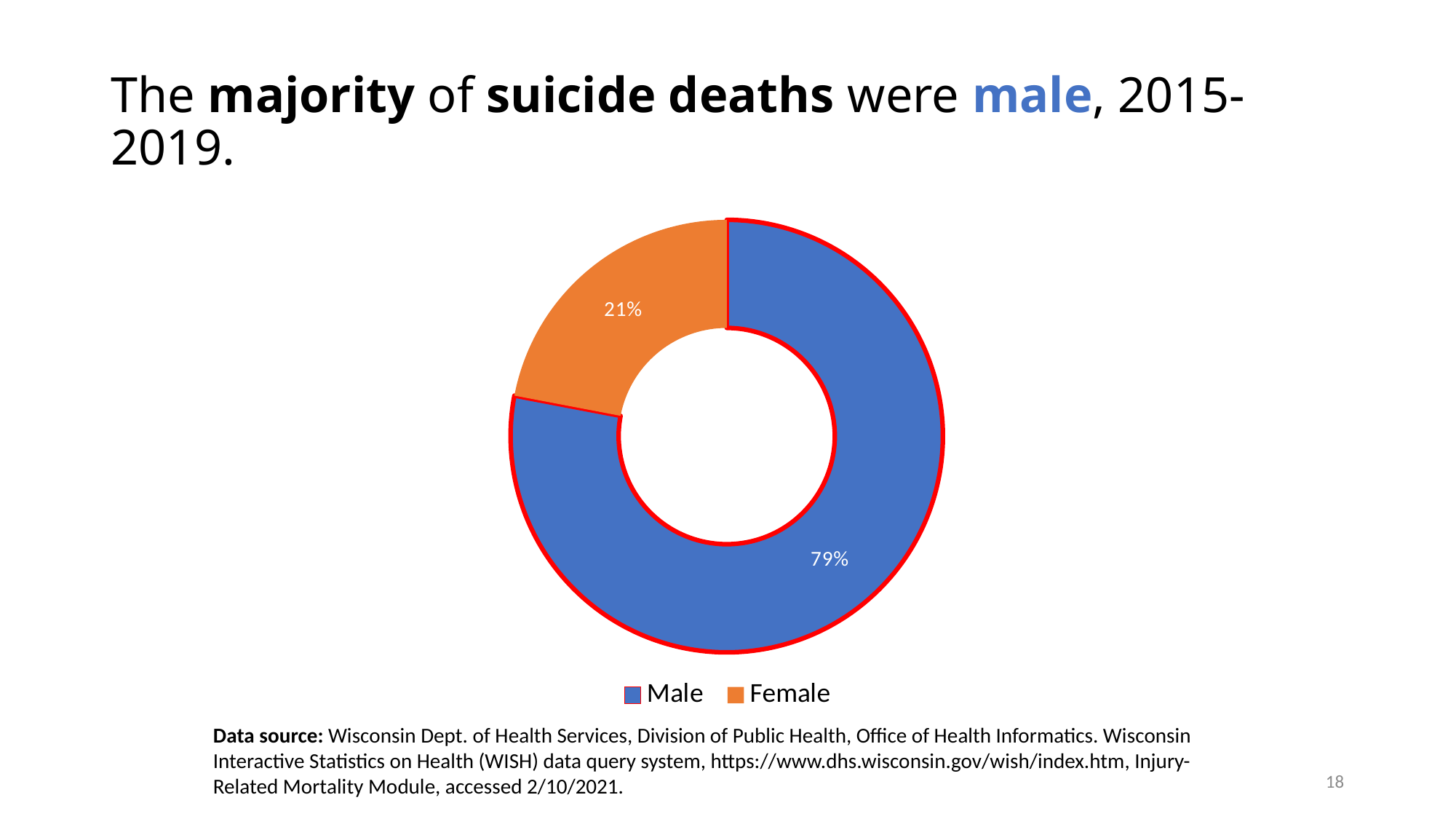
Which category has the largest share of the chart? Male What colour is the Male slice? Blue Which is larger, the male share or the female share? Male How many entries does the legend list? 2 What is the difference in percentage points between the male and female shares? 58 How many categories are shown in the chart? 2 What percentage of suicide deaths were male? 79% What kind of chart is shown on the slide? Doughnut (pie) chart What colour is the Female slice? Orange What share of the chart does the Female slice represent? 21% What percentage of suicide deaths were female? 21% Which category has the smallest share of the chart? Female